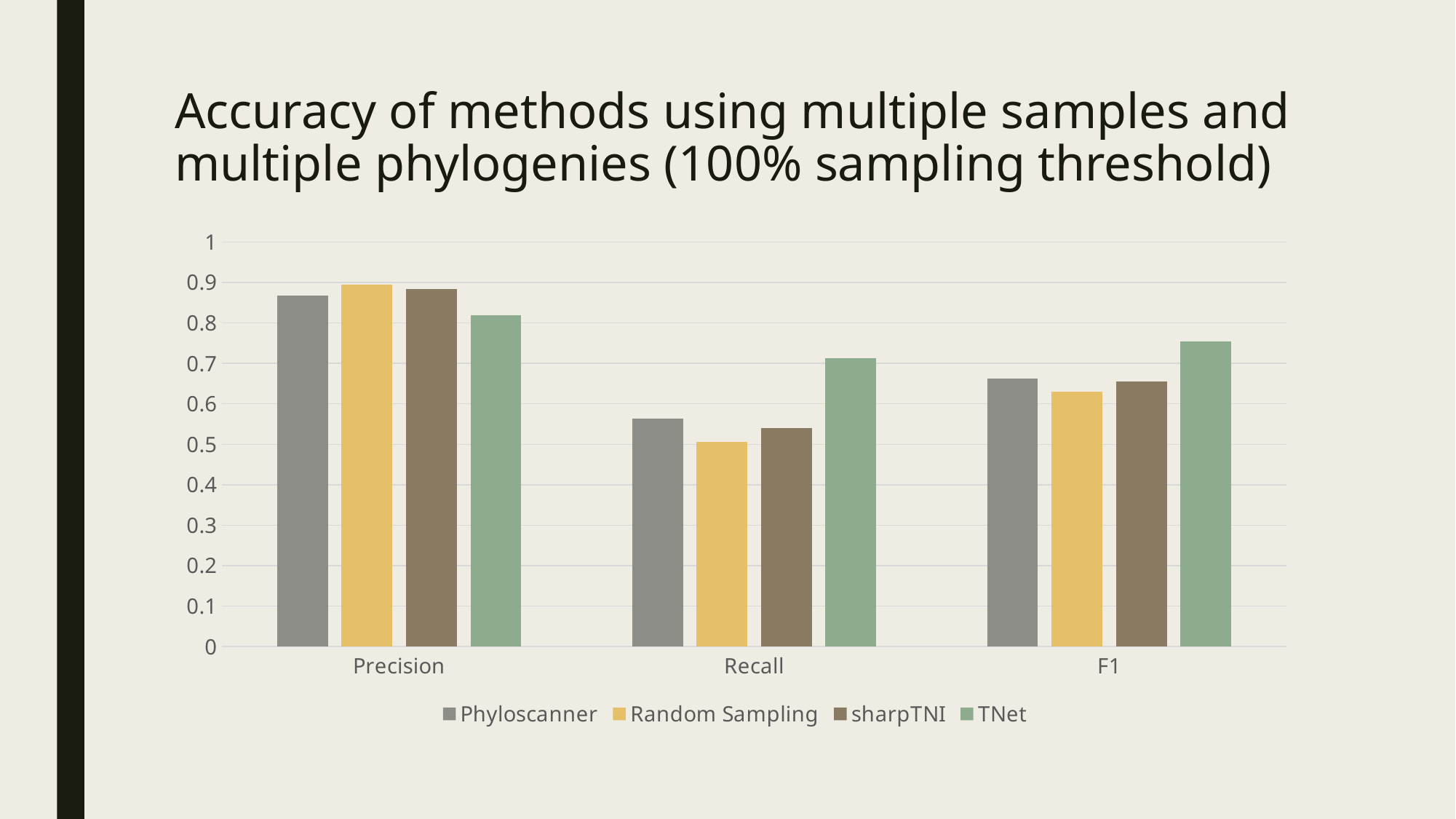
Which colour represents TNet in the legend? green Which is larger for TNet: its Precision or its Recall? Precision Which method has the highest F1? TNet How many categories are shown on the x axis? 3 Is the F1 value for TNet greater or less than 0.7? greater Which method has the lowest Recall? Random Sampling What kind of chart is shown on the slide? bar chart Which method has the lowest Precision? TNet Is the Recall value for Random Sampling greater or less than 0.6? less How many series does the legend list? 4 Is the Precision value for Phyloscanner greater or less than 0.8? greater Which method has the highest Recall? TNet